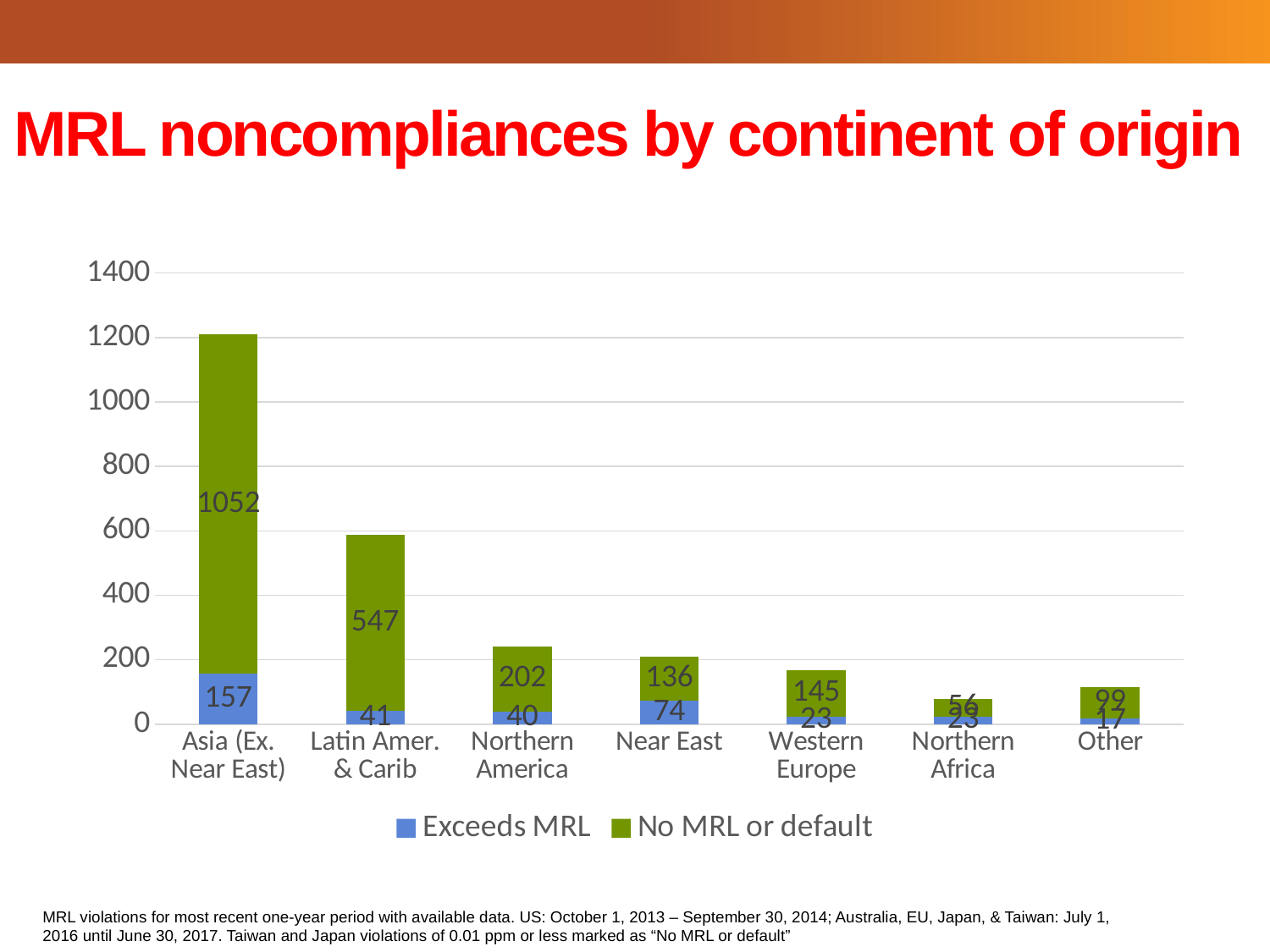
What is the 'No MRL or default' value for Asia (Ex. Near East)? 1052 What is the difference between the 'No MRL or default' values for Asia (Ex. Near East) and Latin Amer. & Carib? 505 What is the 'Exceeds MRL' value for Near East? 74 How many series does the legend list? 2 Which colour represents the 'Exceeds MRL' series in the legend? Blue What kind of chart is shown on the slide? Stacked bar chart Is the total of the stacked bar for Northern America greater or less than 200? greater What is the total of the stacked bar for Latin Amer. & Carib? 588 What is the 'No MRL or default' value for Western Europe? 145 How many continent-of-origin categories are shown on the x axis? 7 Which category has the highest total number of noncompliances? Asia (Ex. Near East) Which has the larger 'Exceeds MRL' value, Near East or Northern America? Near East